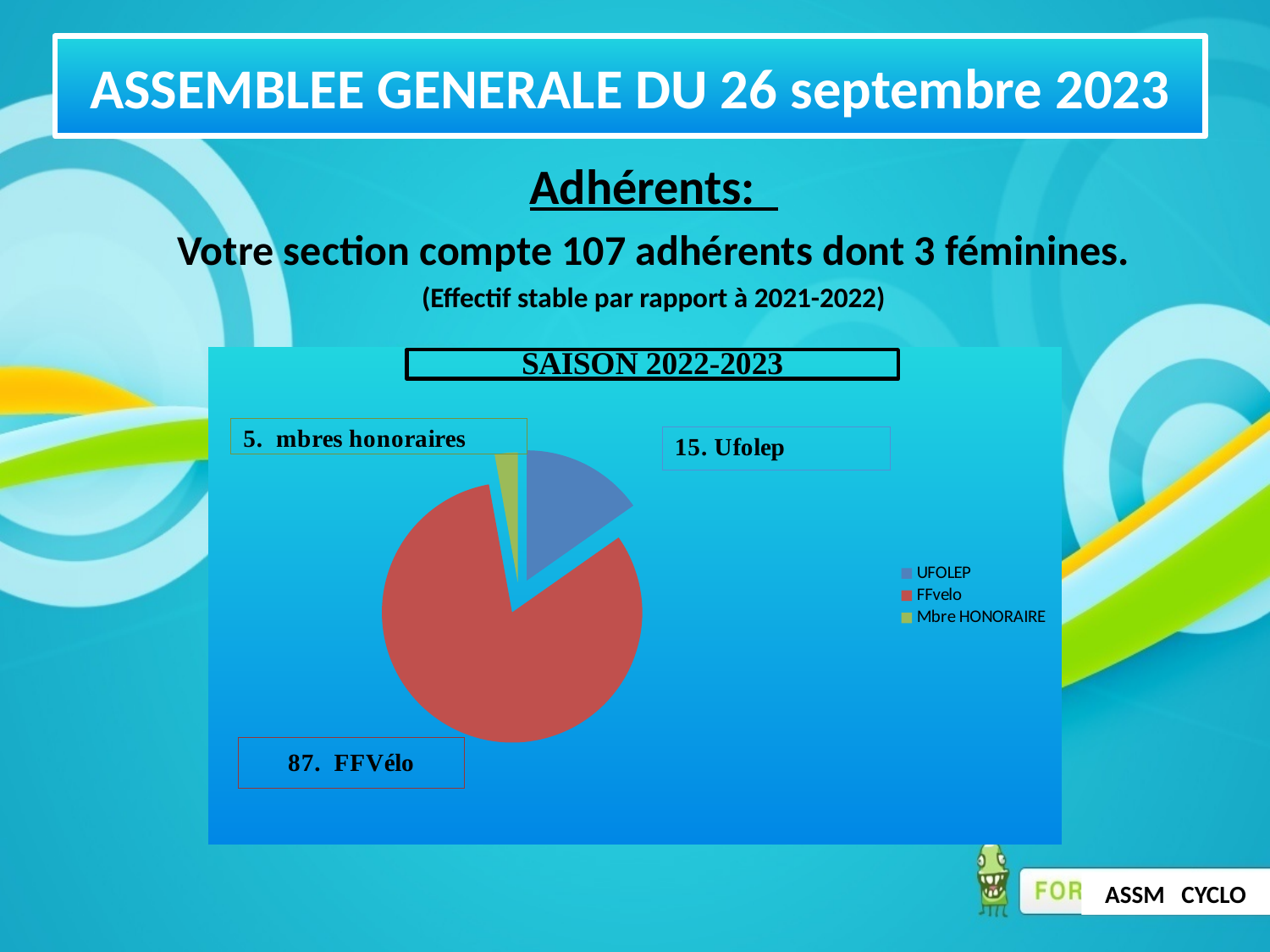
How many series does the chart legend list? 3 What type of chart is shown on the slide? pie chart Which category has the largest slice of the pie chart? FFvelo What is the difference between the FFVélo value and the Ufolep value? 72 How many slices does the pie chart have? 3 What is the value for FFVélo in the pie chart? 87 Which colour represents FFvelo in the pie chart? red What is the value for Ufolep in the pie chart? 15 What is the value for membres honoraires in the pie chart? 5 Which category has the smallest slice of the pie chart? Mbre HONORAIRE What is the title of the chart? SAISON 2022-2023 Which is larger, the Ufolep value or the membres honoraires value? Ufolep